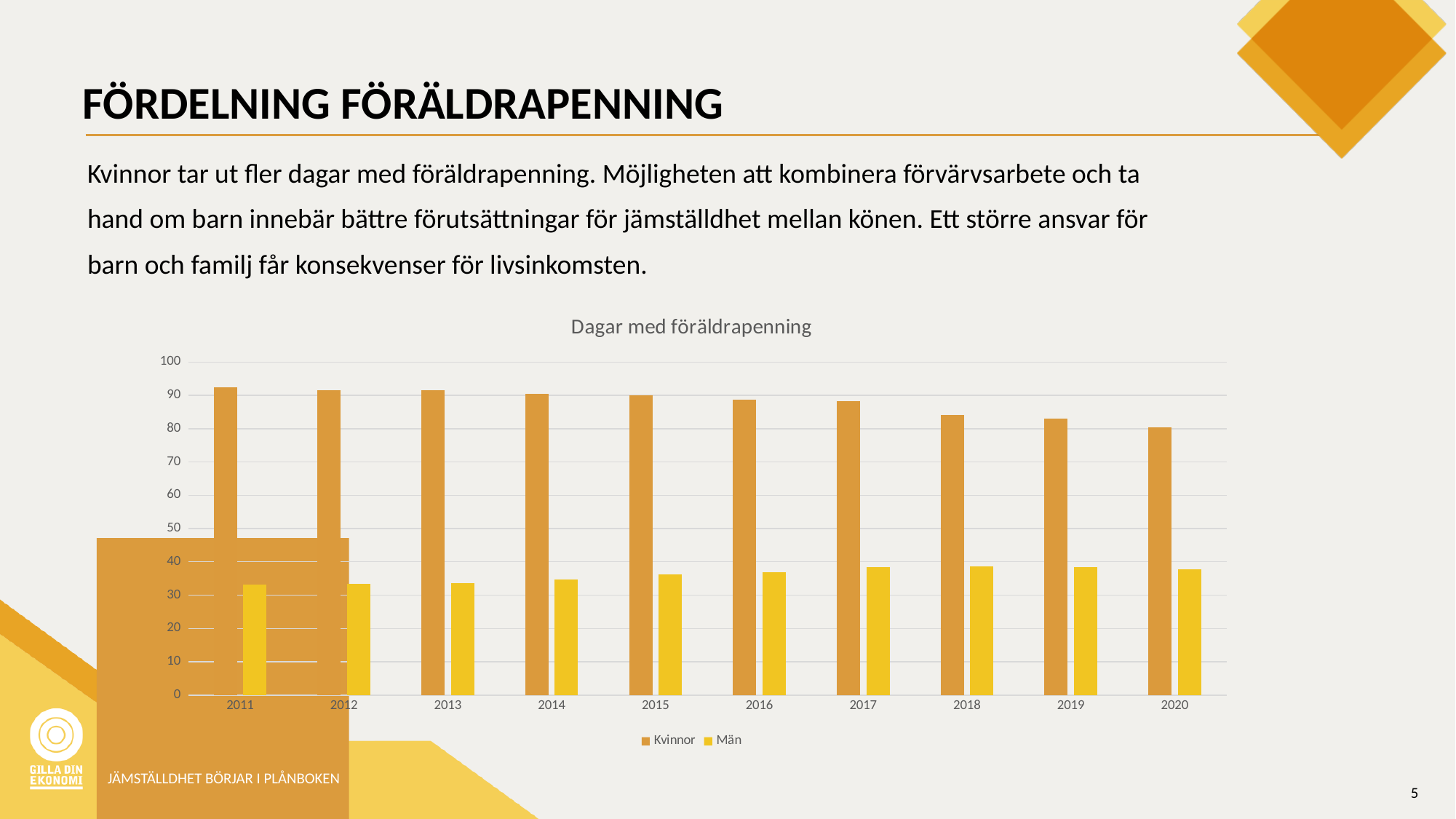
Is the value for Kvinnor in 2020 greater or less than 90? less Is the value for Kvinnor in 2011 greater or less than 90? greater What kind of chart is shown on the slide? Bar chart Is the value for Män in 2011 greater or less than 30? greater How many years are shown on the x axis of the chart? 10 Which series is shown in the lighter yellow colour? Män How many series does the legend list? 2 What is the title of the chart? Dagar med föräldrapenning Which is larger in 2015, the value for Kvinnor or the value for Män? Kvinnor In which year is the value for Kvinnor lowest? 2020 Do the values for Kvinnor rise or fall from 2011 to 2020? fall